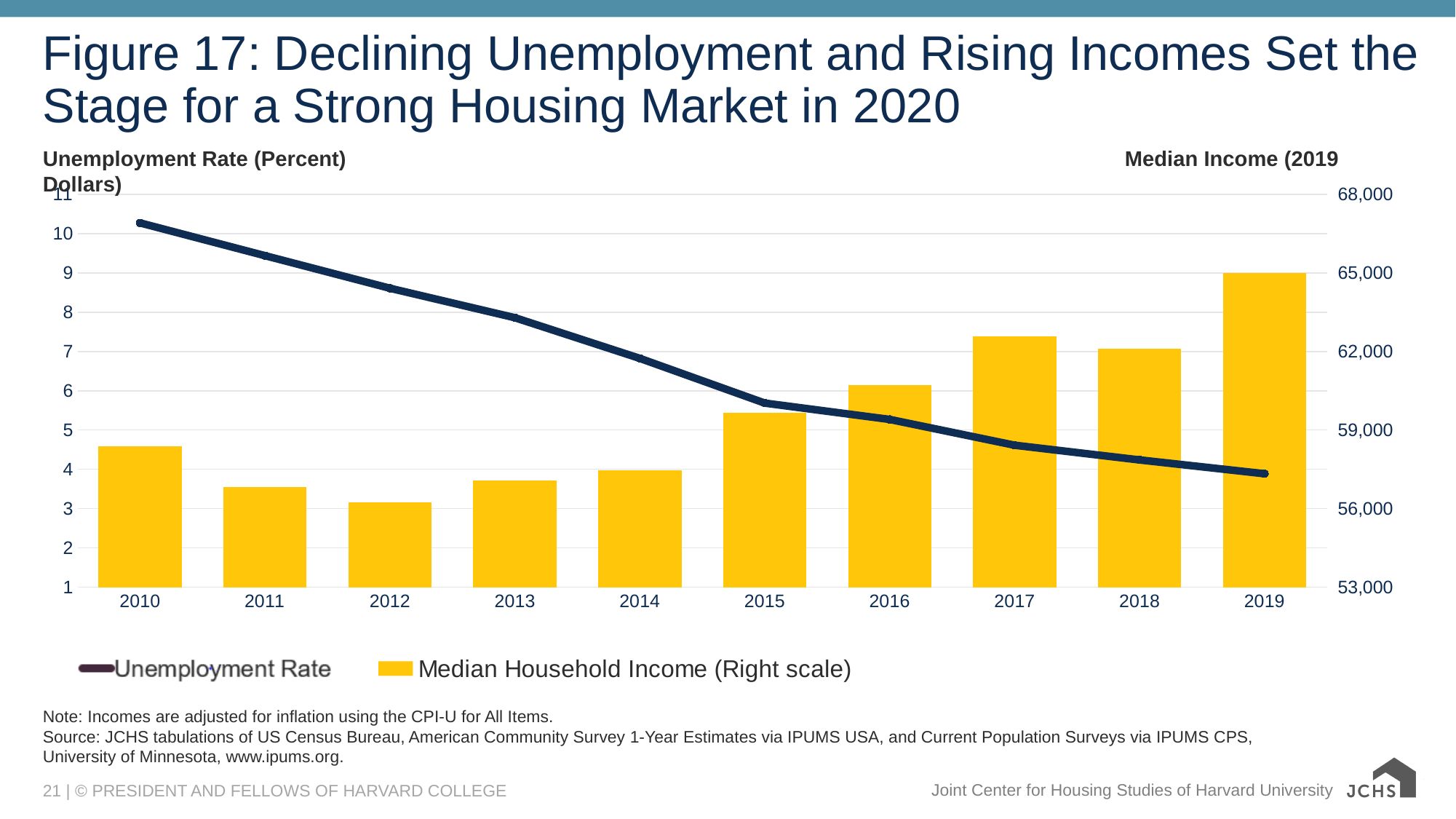
Does the Unemployment Rate line rise or fall from 2010 to 2019? Fall Which year has the highest Median Household Income bar? 2019 Is the Median Household Income for 2019 greater or less than 62,000? greater Which year has a higher Median Household Income, 2015 or 2016? 2016 What kind of chart is shown on the slide? A combination bar and line chart How many series does the legend list? 2 Is the Unemployment Rate for 2019 greater or less than 5? less How many years are shown on the x axis? 10 Is the Median Household Income for 2016 greater or less than 59,000? greater Which series is plotted on the right scale according to the legend? Median Household Income Which year has the lowest Median Household Income bar? 2012